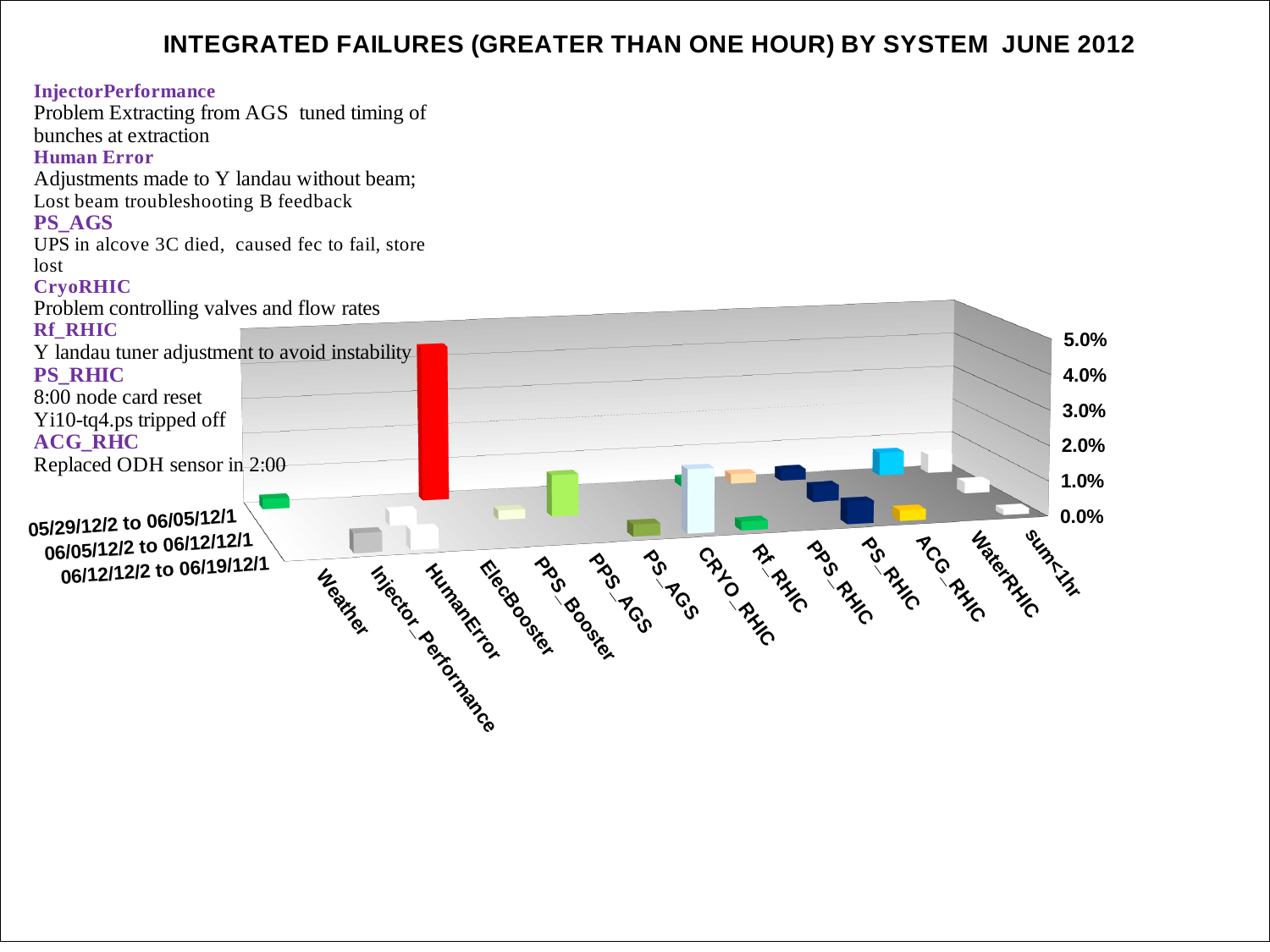
Is the tallest bar for HumanError greater or less than 2.0%? less What is the label of the first category on the x axis of the chart? Weather How many system categories are shown along the x axis of the chart? 14 Which system category has the tallest bar in the chart? ElecBooster What colour is the tallest bar in the chart? red What is the highest value labelled on the vertical axis of the chart? 5.0% What is the label of the last category on the x axis of the chart? sum<1hr What kind of chart is shown on the slide? bar chart Which has the larger bar, HumanError or PPS_Booster? HumanError How many date-range series are plotted in the chart? 3 What is the title of the chart on the slide? INTEGRATED FAILURES (GREATER THAN ONE HOUR) BY SYSTEM JUNE 2012 Is the value for Weather greater or less than 1.0%? less